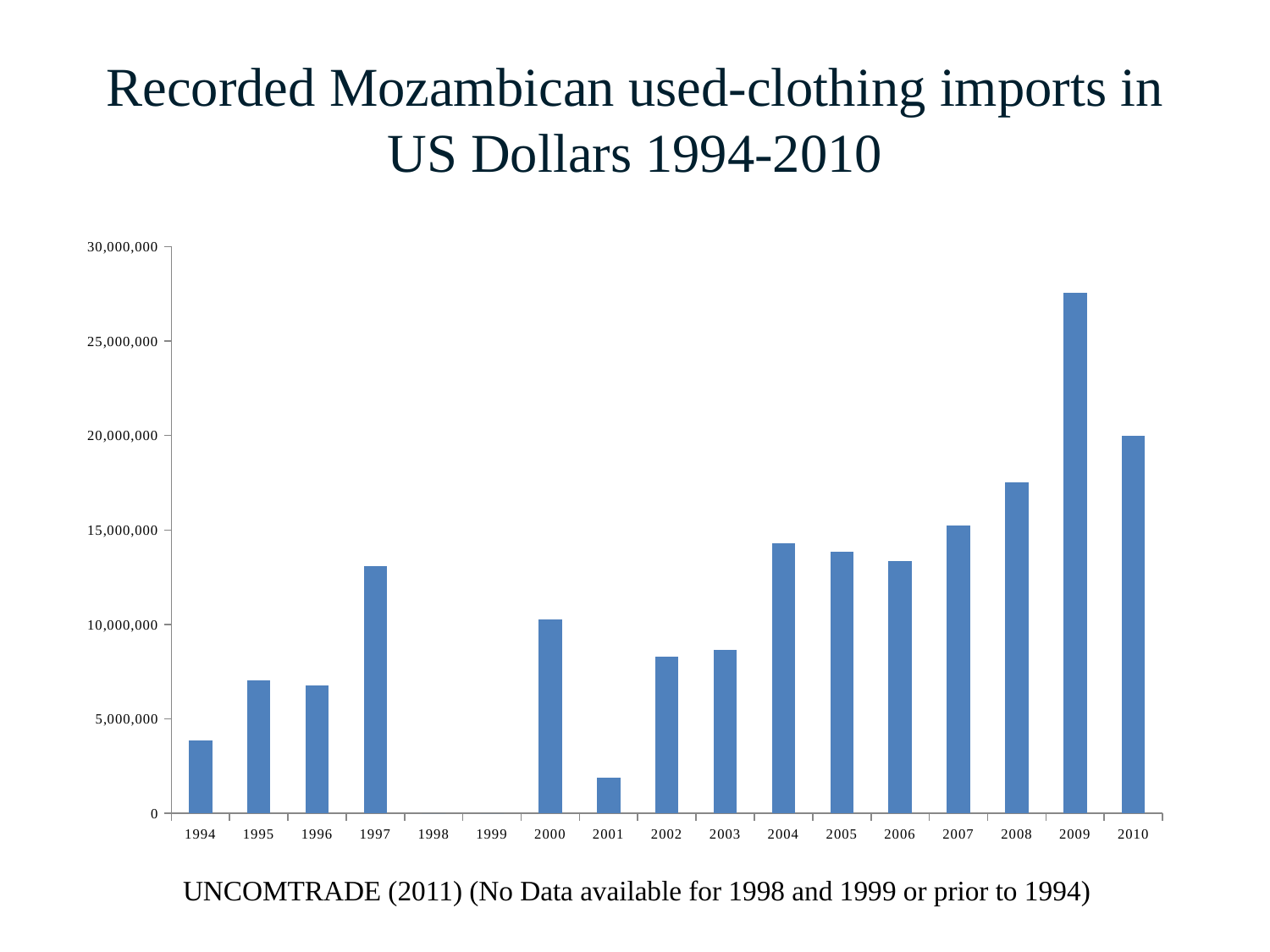
What kind of chart is shown on the slide? bar chart Is the value for 1994 greater or less than 5,000,000? less Do the values rise or fall from 2006 to 2009? rise How many years are labelled on the x axis? 17 Which year has the larger value, 1997 or 2000? 1997 Is the value for 2008 greater or less than 15,000,000? greater Which year has the highest recorded used-clothing imports? 2009 Is the value for 2001 greater or less than 5,000,000? less Which year has the larger value, 2009 or 2010? 2009 Among the years with a bar shown, which year has the lowest recorded imports? 2001